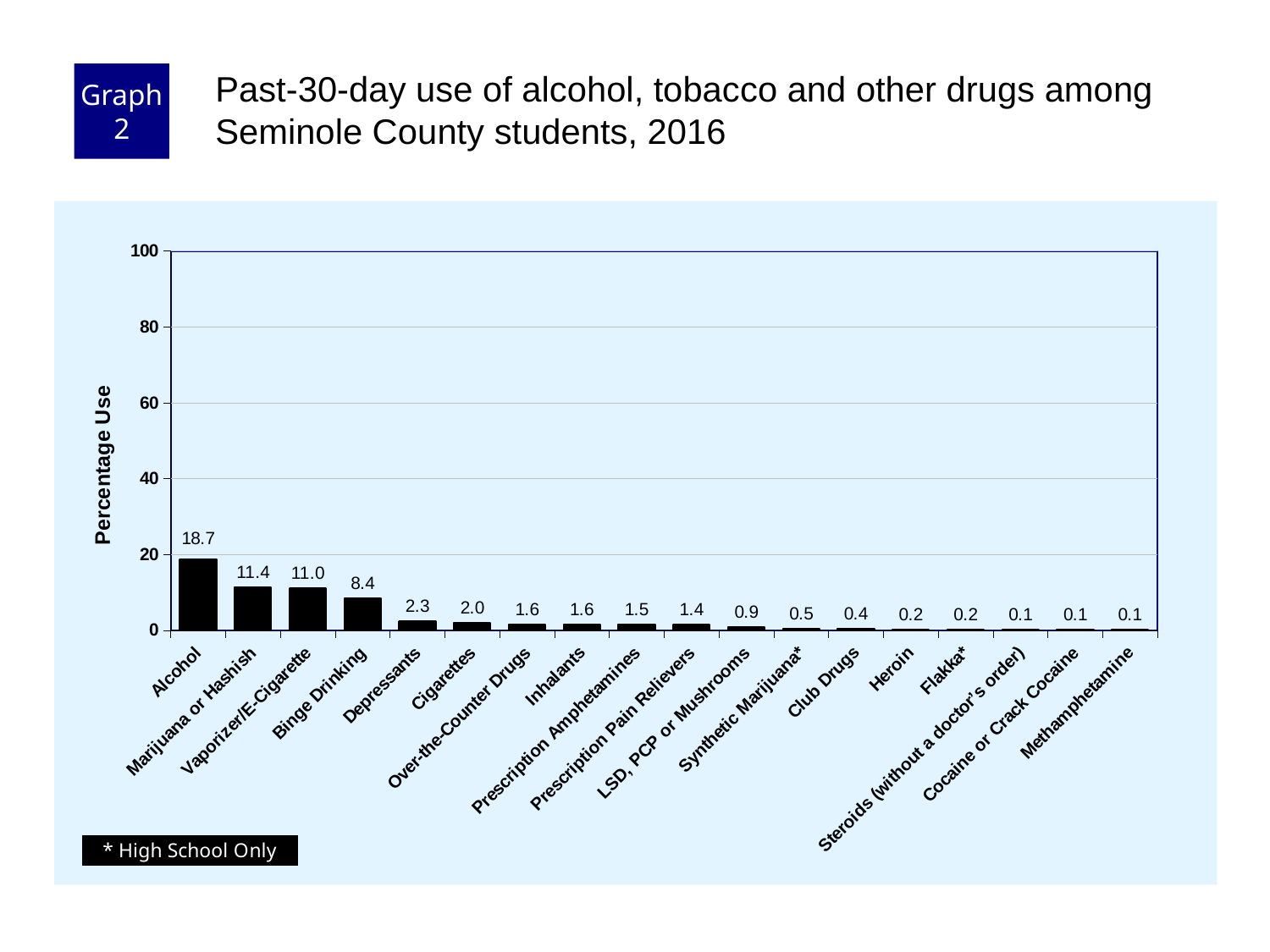
Which has a higher percentage use, Vaporizer/E-Cigarette or Binge Drinking? Vaporizer/E-Cigarette What is the percentage use for Heroin? 0.2 What is the difference in percentage use between Binge Drinking and Depressants? 6.1 What is the percentage use for Cigarettes? 2.0 What is the percentage use for Binge Drinking? 8.4 What is the difference in percentage use between Alcohol and Marijuana or Hashish? 7.3 How many categories are shown on the x axis? 18 What is the label of the y axis? Percentage Use What is the percentage use for Alcohol? 18.7 Is the value for Alcohol greater or less than 20? less What kind of chart is shown on the slide? bar chart Which category has the highest percentage use? Alcohol